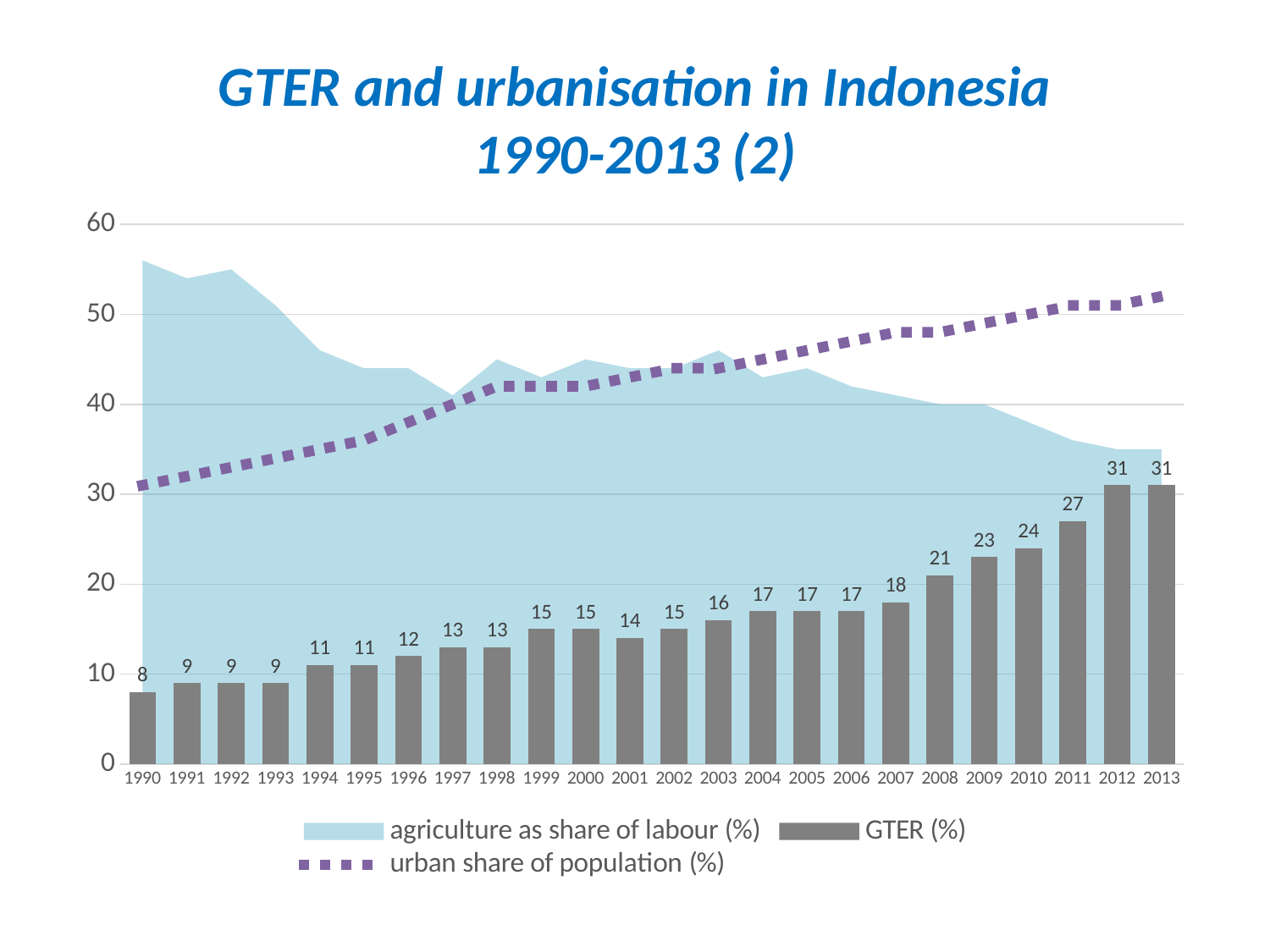
Is the value of urban share of population (%) in 2013 greater or less than 50? greater What is the GTER (%) value for 1990? 8 Which is larger, the GTER (%) value for 2001 or for 2003? 2003 Does the urban share of population (%) rise or fall from 1990 to 2013? rise In which year is GTER (%) lowest? 1990 What is the difference between the GTER (%) values for 2013 and 1990? 23 What is the GTER (%) value for 2013? 31 Is the value of agriculture as share of labour (%) in 1990 greater or less than 50? greater How many series does the legend list? 3 What is the GTER (%) value for 2008? 21 How many years are shown on the x axis? 24 Which series is drawn as a dotted line? urban share of population (%)